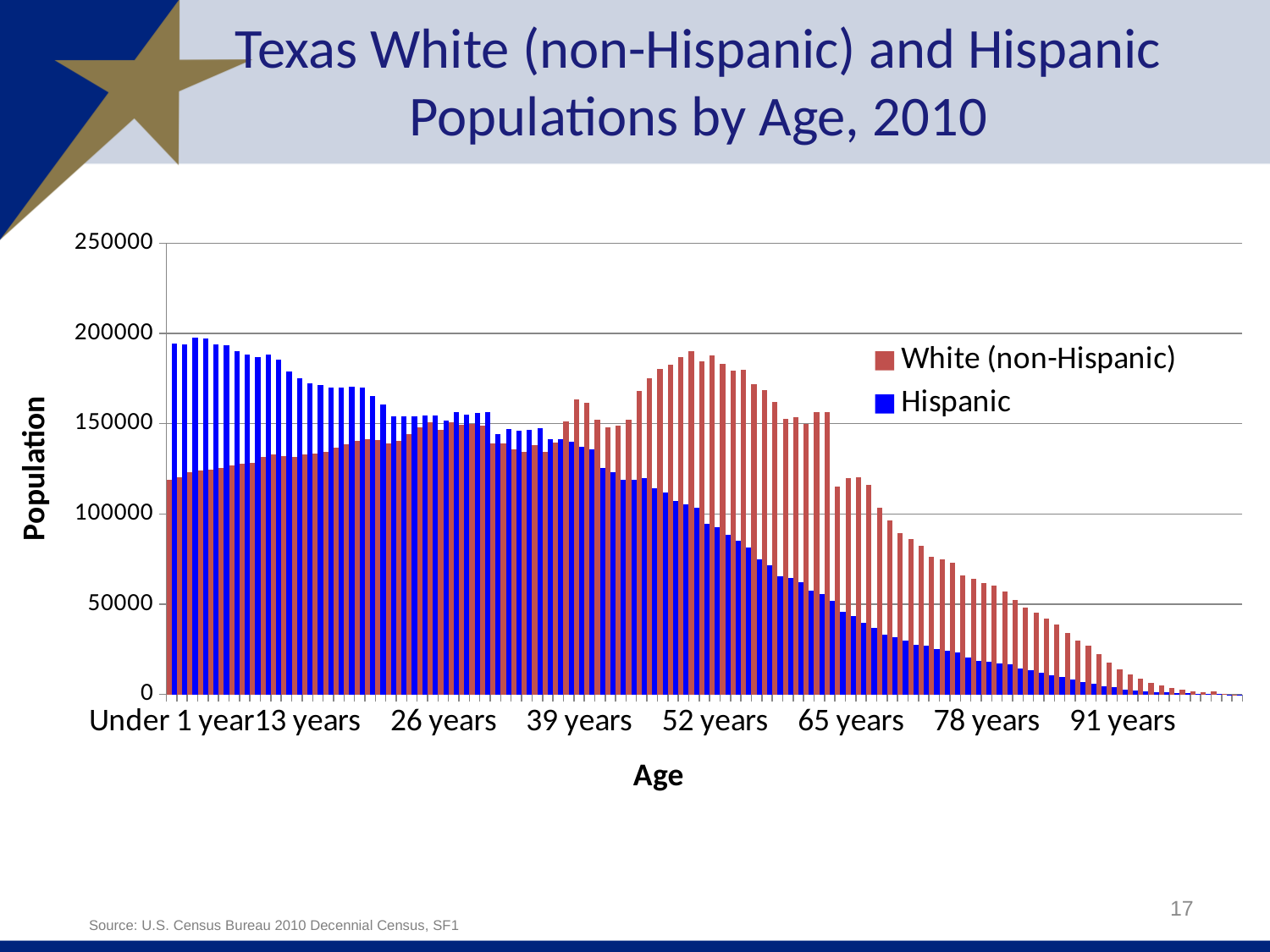
What kind of chart is shown on the slide? bar chart How many series does the legend list? 2 Do the Hispanic values generally rise or fall from Under 1 year to 91 years? fall What is the title of the chart? Texas White (non-Hispanic) and Hispanic Populations by Age, 2010 What is the label of the vertical axis? Population Is the Hispanic value for 78 years greater or less than 50000? less At Under 1 year, which series has the larger value, White (non-Hispanic) or Hispanic? Hispanic At 52 years, which series has the larger value, White (non-Hispanic) or Hispanic? White (non-Hispanic) Is the Hispanic value for Under 1 year greater or less than 150000? greater Is the White (non-Hispanic) value for 52 years greater or less than 150000? greater